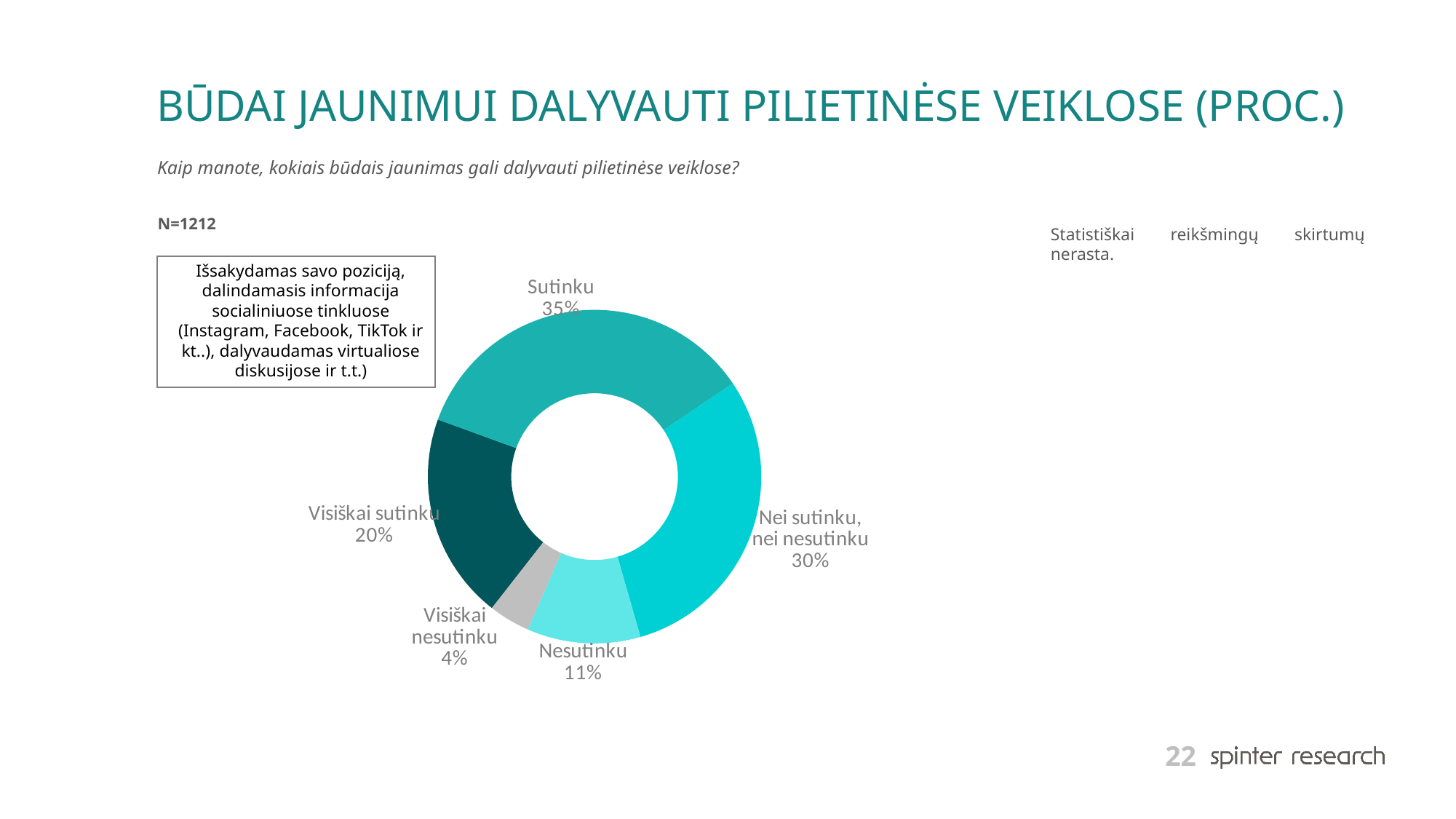
What type of chart is shown on the slide? Pie chart (donut) Which is larger: the share for "Visiškai sutinku" or the share for "Nesutinku"? Visiškai sutinku Which response category has the smallest share of the chart? Visiškai nesutinku What percentage of respondents answered "Visiškai nesutinku"? 4% What is the combined share of "Sutinku" and "Visiškai sutinku"? 55% What is the difference in percentage points between "Sutinku" and "Nei sutinku, nei nesutinku"? 5 What percentage of respondents answered "Nesutinku"? 11% Which response category has the largest share of the chart? Sutinku What percentage of respondents answered "Visiškai sutinku"? 20% What percentage of respondents answered "Nei sutinku, nei nesutinku"? 30% How many response categories are shown in the chart? 5 What percentage of respondents answered "Sutinku"? 35%